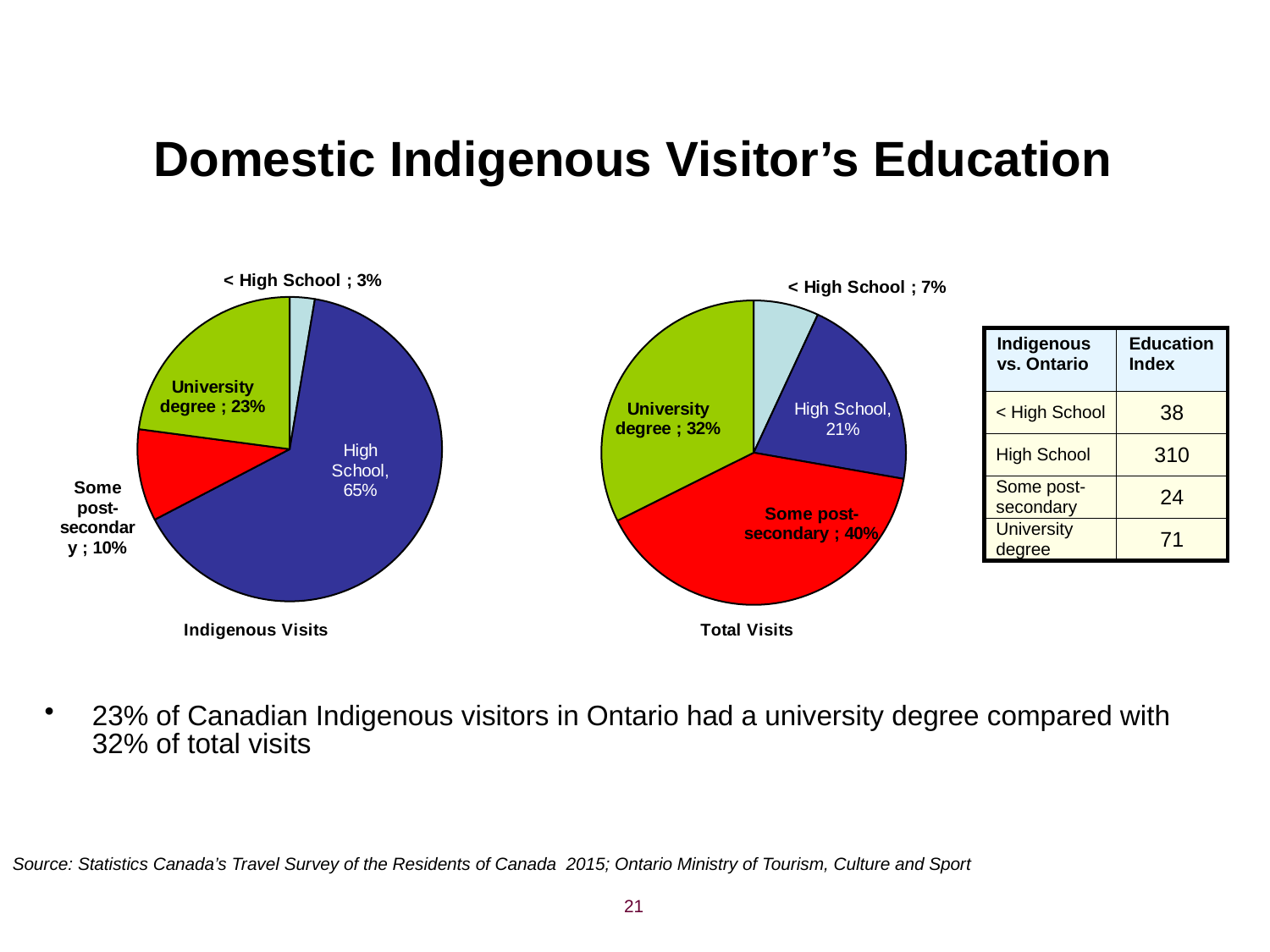
In the Indigenous Visits pie chart, what share of visits is for University degree? 23% In the Total Visits pie chart, which category has the smallest slice? < High School In the Total Visits pie chart, what share of visits is for Some post-secondary? 40% Which is larger: the High School share in the Indigenous Visits pie chart or in the Total Visits pie chart? Indigenous Visits In the Indigenous Visits pie chart, which category has the smallest slice? < High School In the Indigenous Visits pie chart, what colour is the Some post-secondary slice? Red How many categories does the Total Visits pie chart show? 4 What is the difference between the University degree share in the Total Visits pie chart and in the Indigenous Visits pie chart? 9% In the Total Visits pie chart, what share of visits is for < High School? 7% What kind of chart is the Indigenous Visits chart? Pie chart In the Indigenous Visits pie chart, what share of visits is for High School? 65% In the Indigenous Visits pie chart, which category has the largest slice? High School